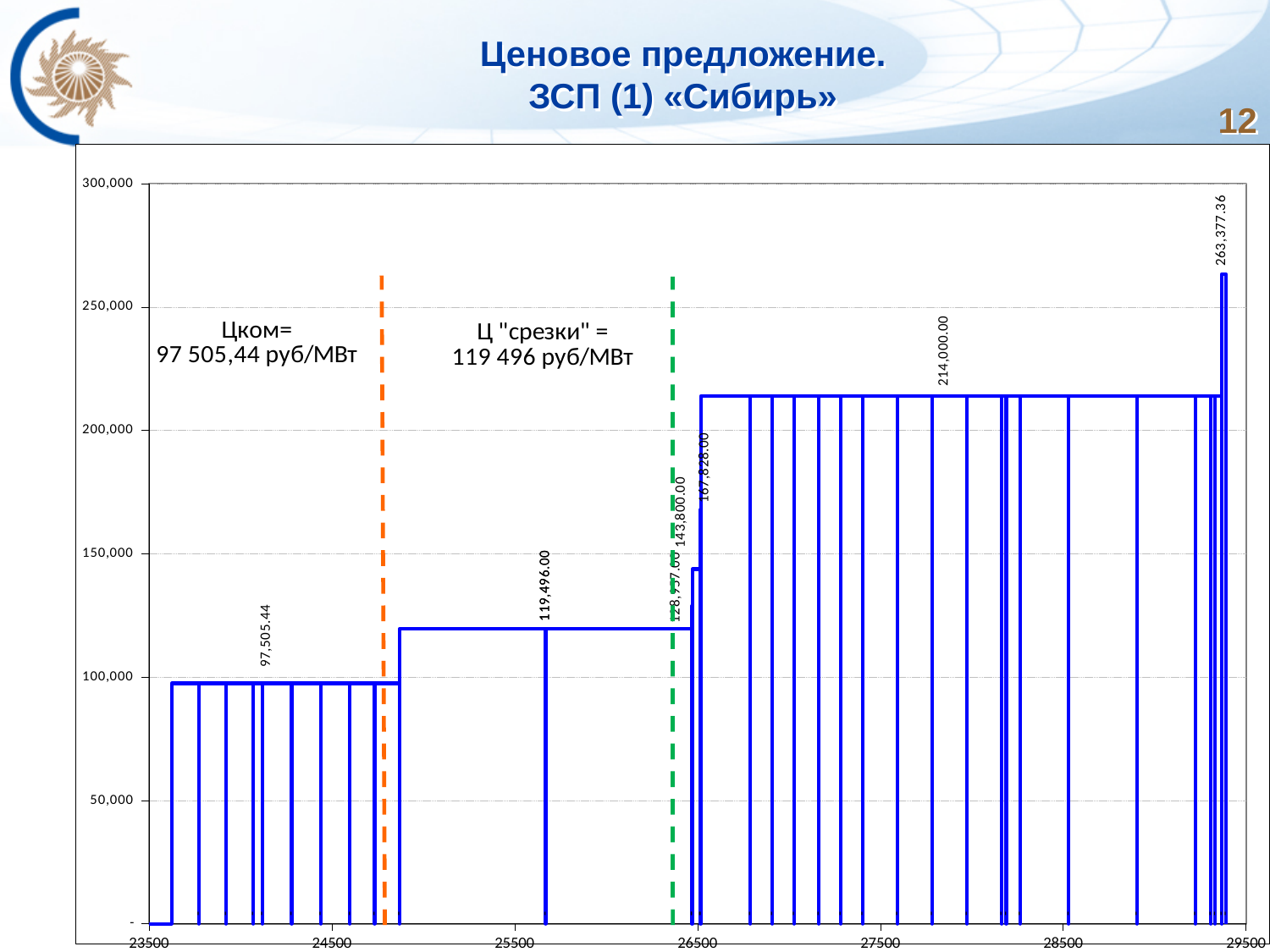
What is the value of the long plateau to the right of the green dashed line, as printed on its data label? 214,000.00 What is the value of the price step labelled between the orange and green dashed lines? 119,496.00 Do the plotted values rise or fall as you move from left to right along the x axis? rise What value does the annotation give for Цком? 97 505,44 руб/МВт What is the lowest value labelled on the chart? 97,505.44 What is the difference between the highest labelled value (263,377.36) and the 214,000.00 plateau? 49,377.36 What value does the annotation give for Ц "срезки"? 119 496 руб/МВт What is the highest value labelled on the chart? 263,377.36 What is the difference between the 214,000.00 step and the 119,496.00 step? 94,504.00 Is the value of the long plateau to the right of the green dashed line greater or less than 200,000? greater Which is larger: the step labelled 143,800.00 or the step labelled 119,496.00? 143,800.00 What is the value of the first (lowest) price step shown on the chart? 97,505.44